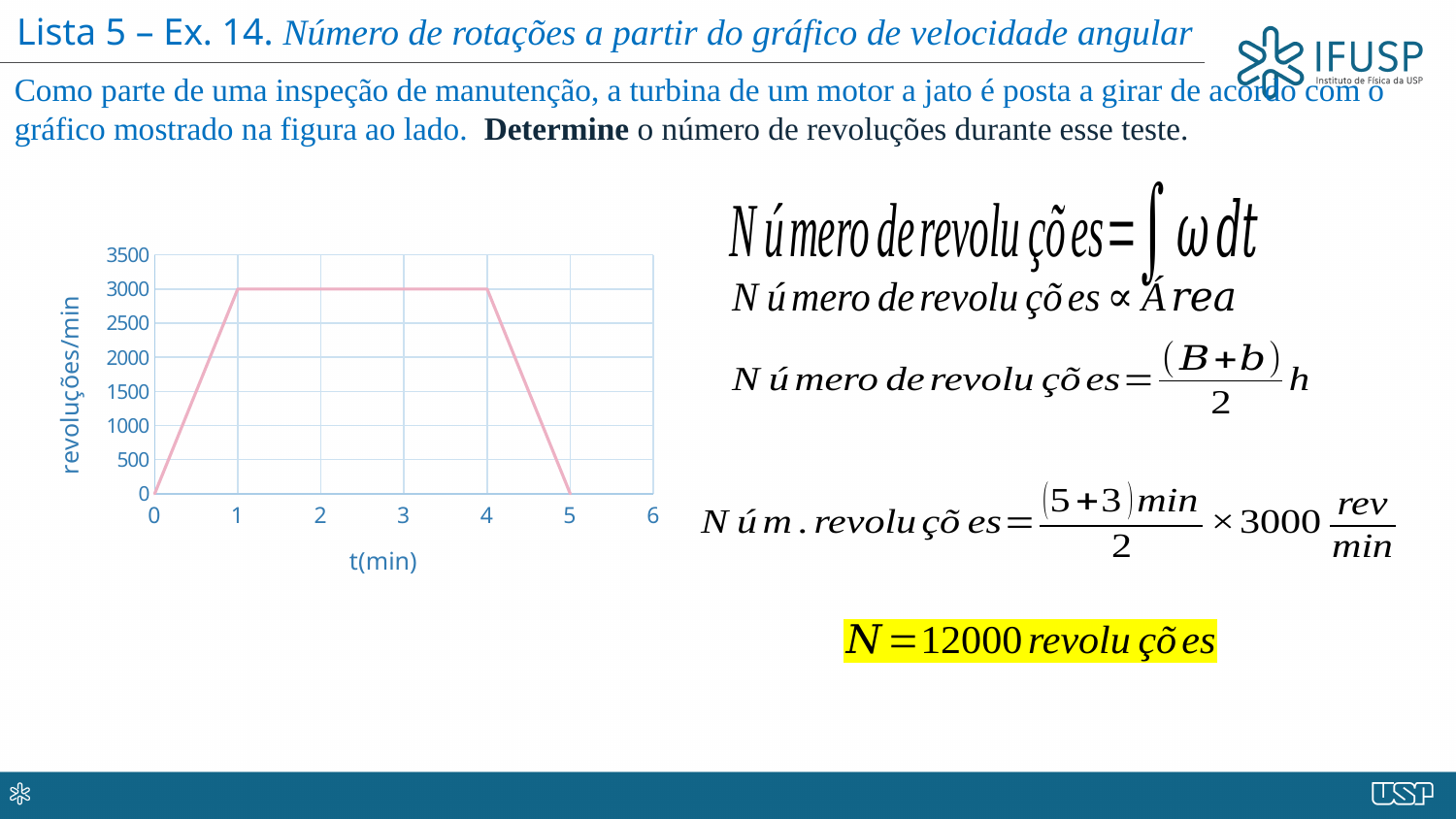
Between t = 1 and t = 4 min, does the value rise, fall, or stay constant? stay constant What is the value of revoluções/min at t = 4 min? 3000 What is the label of the y axis? revoluções/min Is the value for t = 2 min greater or less than 2500? greater What is the label of the x axis? t(min) Is the value for t = 0.5 min greater or less than 2000? less What kind of chart is shown on the slide? line chart What is the value of revoluções/min at t = 1 min? 3000 What is the value of revoluções/min at t = 5 min? 0 Between t = 0 and t = 1 min, does the value rise or fall? rise Between t = 4 and t = 5 min, does the value rise or fall? fall What is the maximum value of revoluções/min reached on the chart? 3000